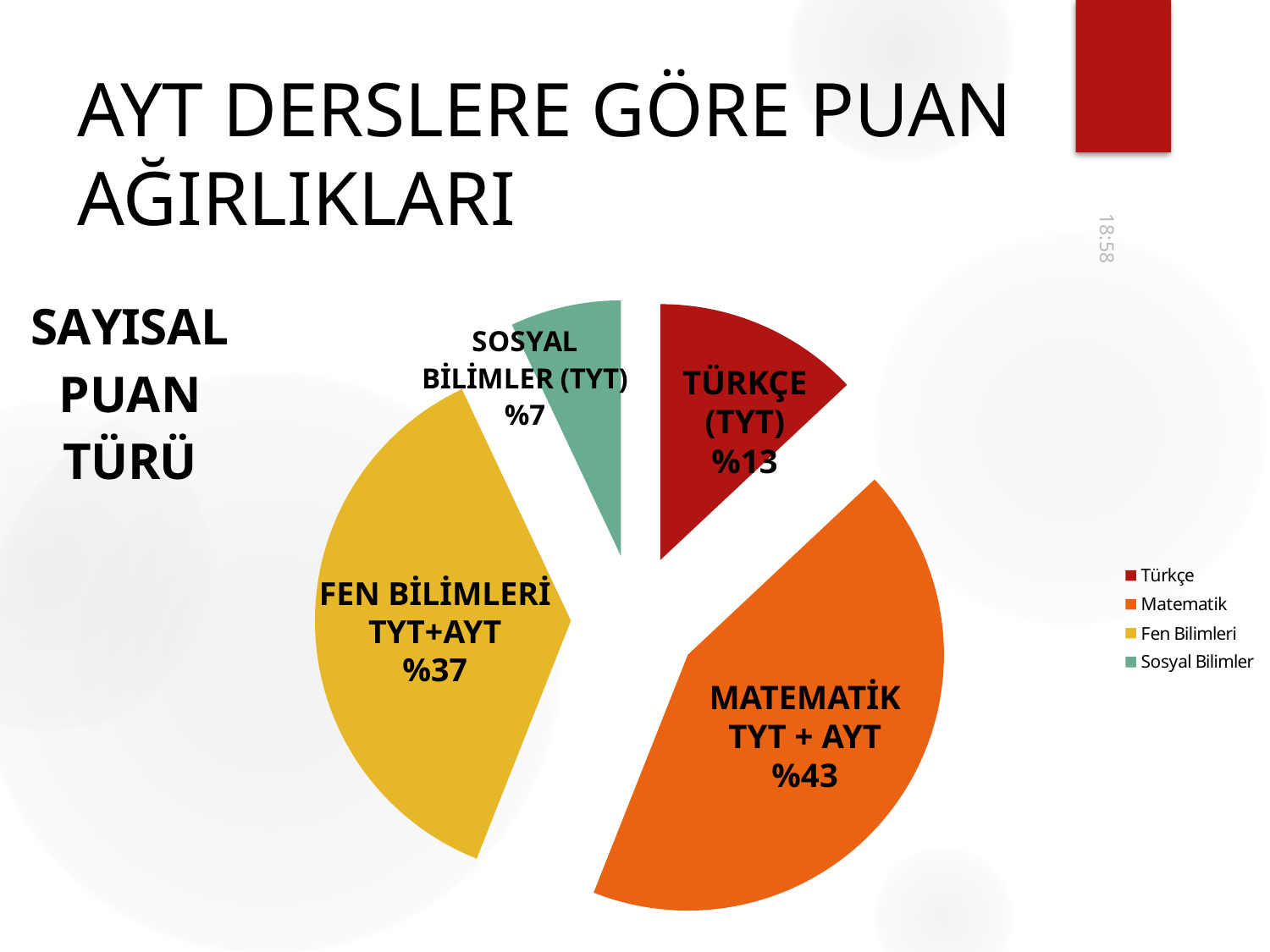
What is the value shown for Fen Bilimleri (TYT+AYT)? %37 How many entries does the legend list? 4 Which slice has the largest share of the pie? Matematik What is the value shown for Matematik (TYT + AYT)? %43 What kind of chart is shown on the slide? pie chart What is the value shown for Türkçe (TYT)? %13 What is the value shown for Sosyal Bilimler (TYT)? %7 How many slices does the pie chart have? 4 What is the difference between the Matematik and Fen Bilimleri values? %6 Which is larger, the Türkçe value or the Sosyal Bilimler value? Türkçe Which slice has the smallest share of the pie? Sosyal Bilimler What colour is the Fen Bilimleri slice? yellow